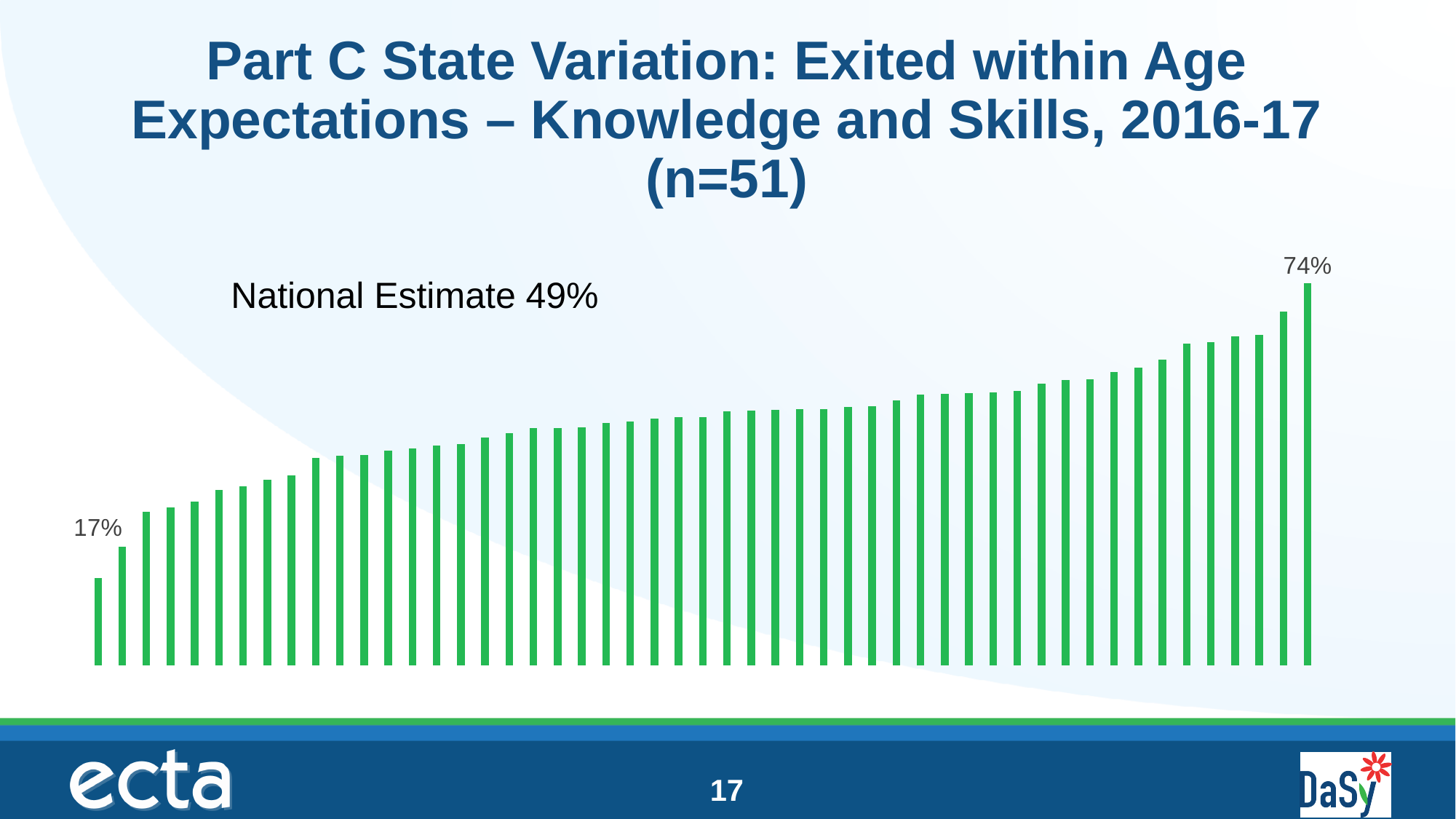
What national estimate is stated on the chart? 49% What is the highest value labelled on the chart? 74% What colour are the bars in the chart? green Do the bar values rise or fall from left to right across the chart? rise What kind of chart is shown on the slide? bar chart Which is larger, the value of the leftmost bar or the value of the rightmost bar? the rightmost bar What is the difference between the highest labelled value (74%) and the lowest labelled value (17%)? 57 percentage points How many states (bars) does the chart represent, according to the title? 51 What is the lowest value labelled on the chart? 17%